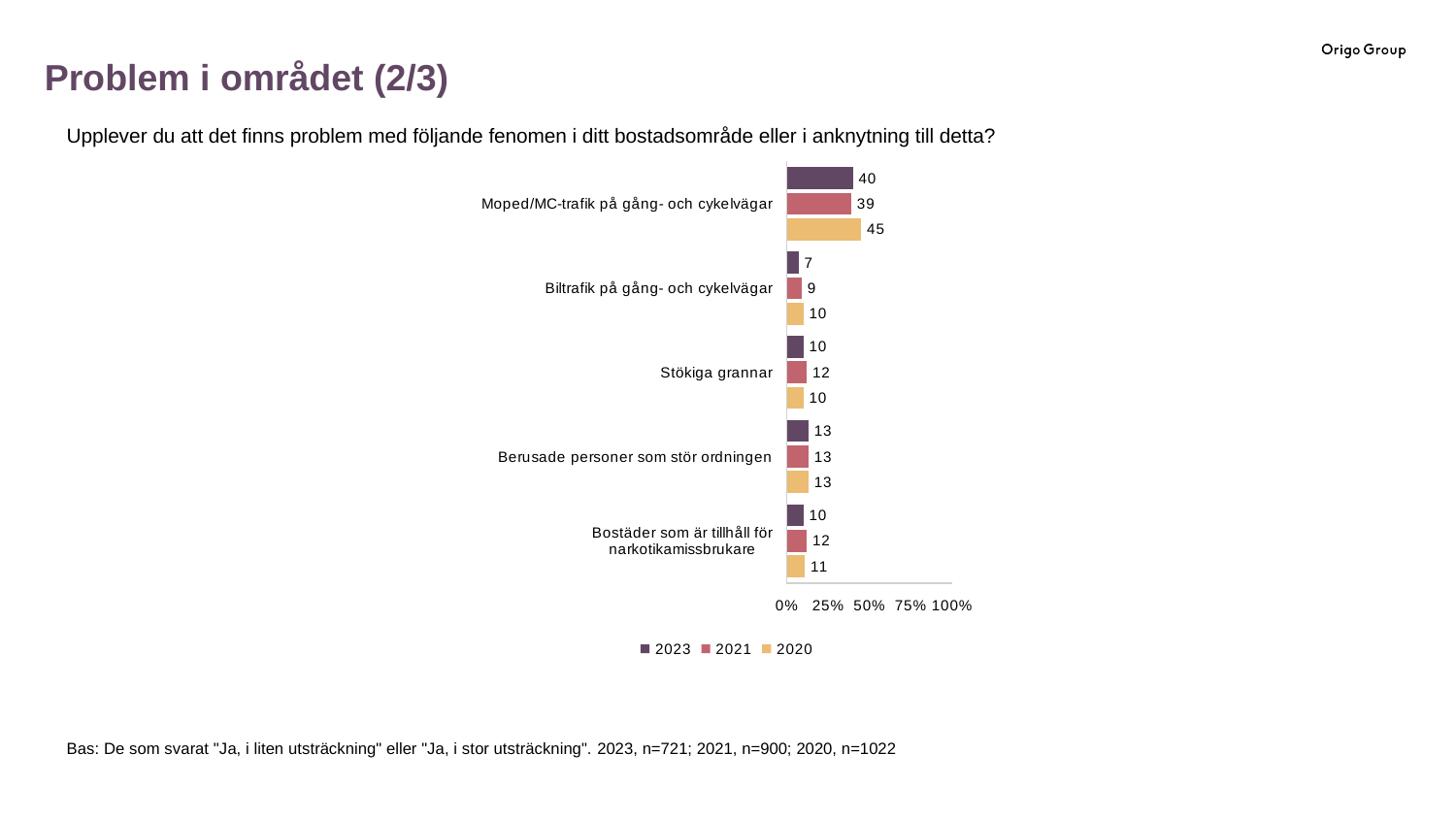
What is the value for "Stökiga grannar" in the 2021 series? 12 What kind of chart is shown on the slide? Bar chart What is the value for "Biltrafik på gång- och cykelvägar" in the 2023 series? 7 What is the value for "Moped/MC-trafik på gång- och cykelvägar" in the 2020 series? 45 How many categories are shown on the chart? 5 Is the 2020 value for "Moped/MC-trafik på gång- och cykelvägar" greater or less than 25%? greater Which series is shown in yellow in the legend? 2020 For "Bostäder som är tillhåll för narkotikamissbrukare", which is larger: the 2021 value or the 2023 value? 2021 Which category has the highest value in the 2023 series? Moped/MC-trafik på gång- och cykelvägar How many series does the legend list? 3 Which category has the lowest value in the 2023 series? Biltrafik på gång- och cykelvägar What is the difference between the 2020 and 2021 values for "Moped/MC-trafik på gång- och cykelvägar"? 6